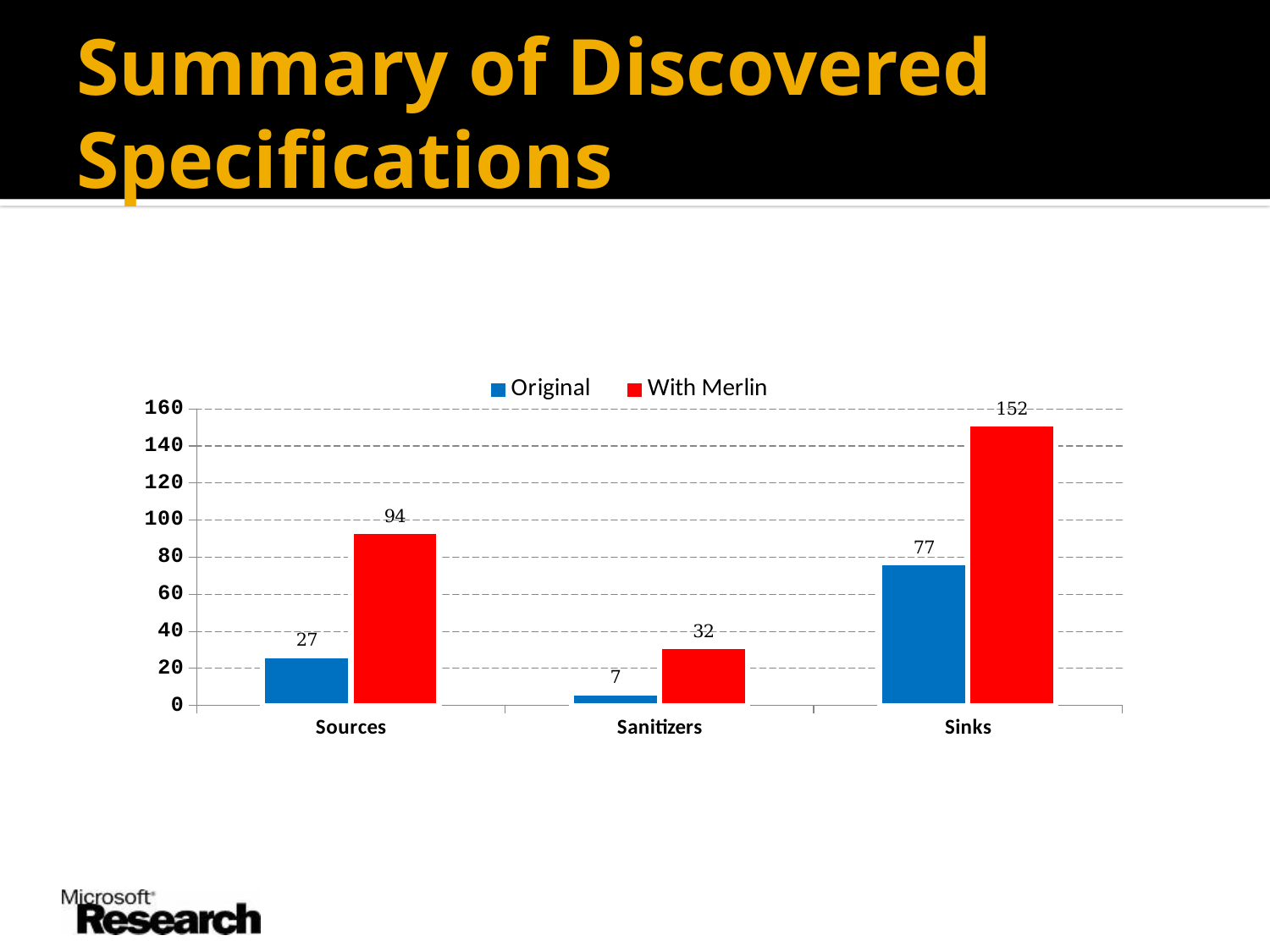
Which category has the lowest Original value? Sanitizers Which is larger: the Original value for Sinks or the With Merlin value for Sources? With Merlin value for Sources What colour are the With Merlin bars? Red What is the difference between the With Merlin and Original values for Sinks? 75 What is the difference between the With Merlin and Original values for Sources? 67 What is the With Merlin value for Sinks? 152 How many categories are shown on the x axis? 3 How many series does the legend list? 2 What is the Original value for Sources? 27 What kind of chart is shown on the slide? Bar chart Which category has the highest With Merlin value? Sinks What is the Original value for Sanitizers? 7